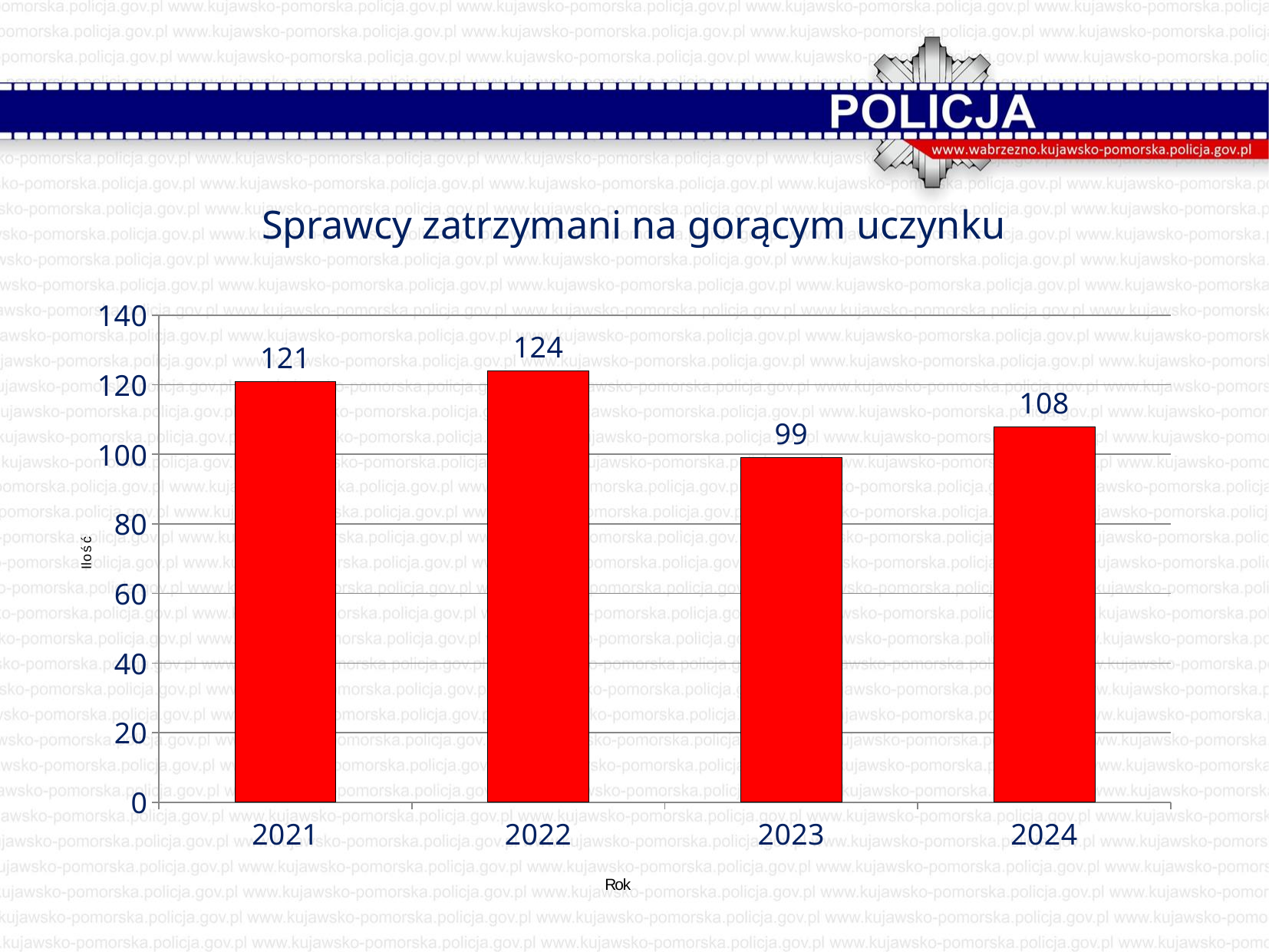
What kind of chart is shown on the slide? bar chart How many years are shown on the x axis? 4 What is the title of the chart? Sprawcy zatrzymani na gorącym uczynku What is the value for 2021? 121 What is the difference between the values for 2022 and 2023? 25 Which year has the highest value? 2022 What is the difference between the values for 2021 and 2024? 13 Which is larger, the value for 2021 or the value for 2024? 2021 What is the value for 2024? 108 Is the value for 2023 greater or less than 100? less Which year has the lowest value? 2023 What is the value for 2023? 99